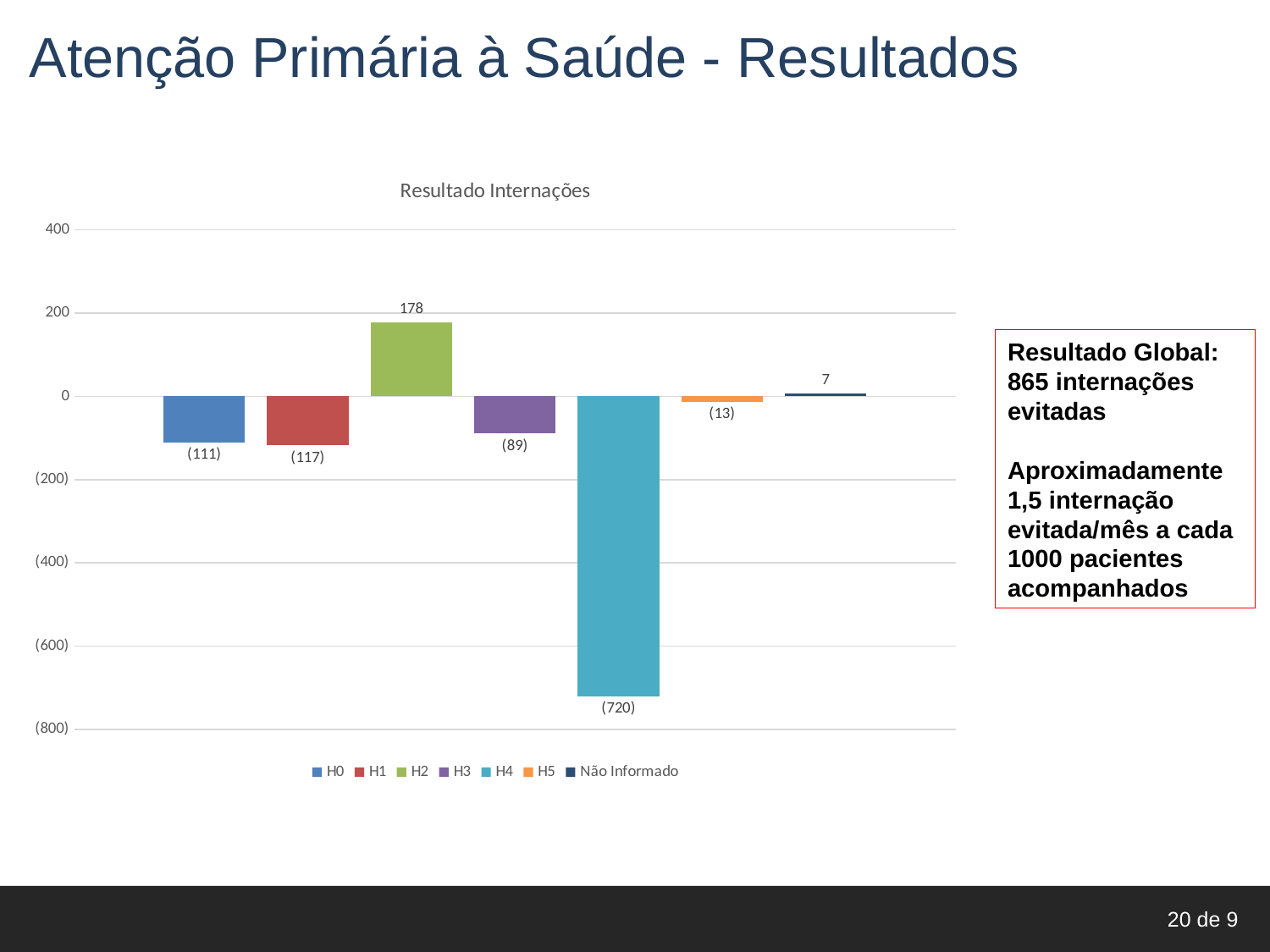
Is the value for H4 greater or less than (600)? less Which is larger, the value for H3 or the value for H5? H5 Which series has the lowest value? H4 What is the value shown for Não Informado? 7 What type of chart is shown on the slide? bar chart Which series has the highest value? H2 What colour is the bar for H2? green What is the value shown for H0? (111) How many series does the legend list? 7 What is the value shown for H2? 178 What is the title of the chart? Resultado Internações What is the value shown for H4? (720)